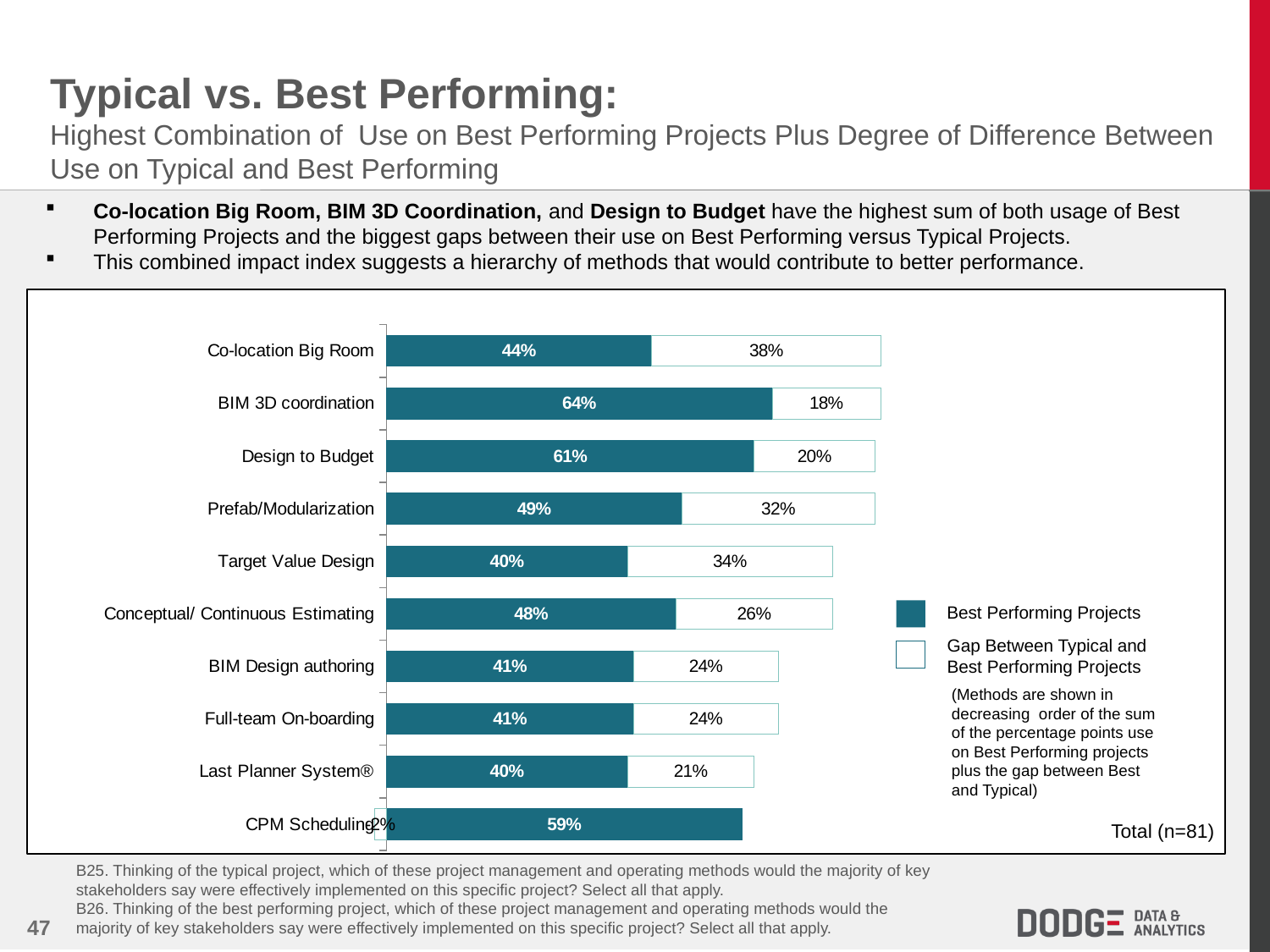
Which category has the largest Gap Between Typical and Best Performing Projects value? Co-location Big Room How many series does the legend list? 2 What is the Best Performing Projects value for Prefab/Modularization? 49% What is the sample size shown on the chart? Total (n=81) Which category has the highest Best Performing Projects value? BIM 3D coordination What is the Best Performing Projects value for BIM 3D coordination? 64% What is the total of the stacked bar for Co-location Big Room? 82% What is the difference between the Best Performing Projects values for Design to Budget and Target Value Design? 21% What is the Gap Between Typical and Best Performing Projects value for Co-location Big Room? 38% How many categories are shown on the chart? 10 Which is larger: the Gap value for Prefab/Modularization or the Gap value for Conceptual/ Continuous Estimating? Prefab/Modularization What kind of chart is shown on the slide? Stacked bar chart